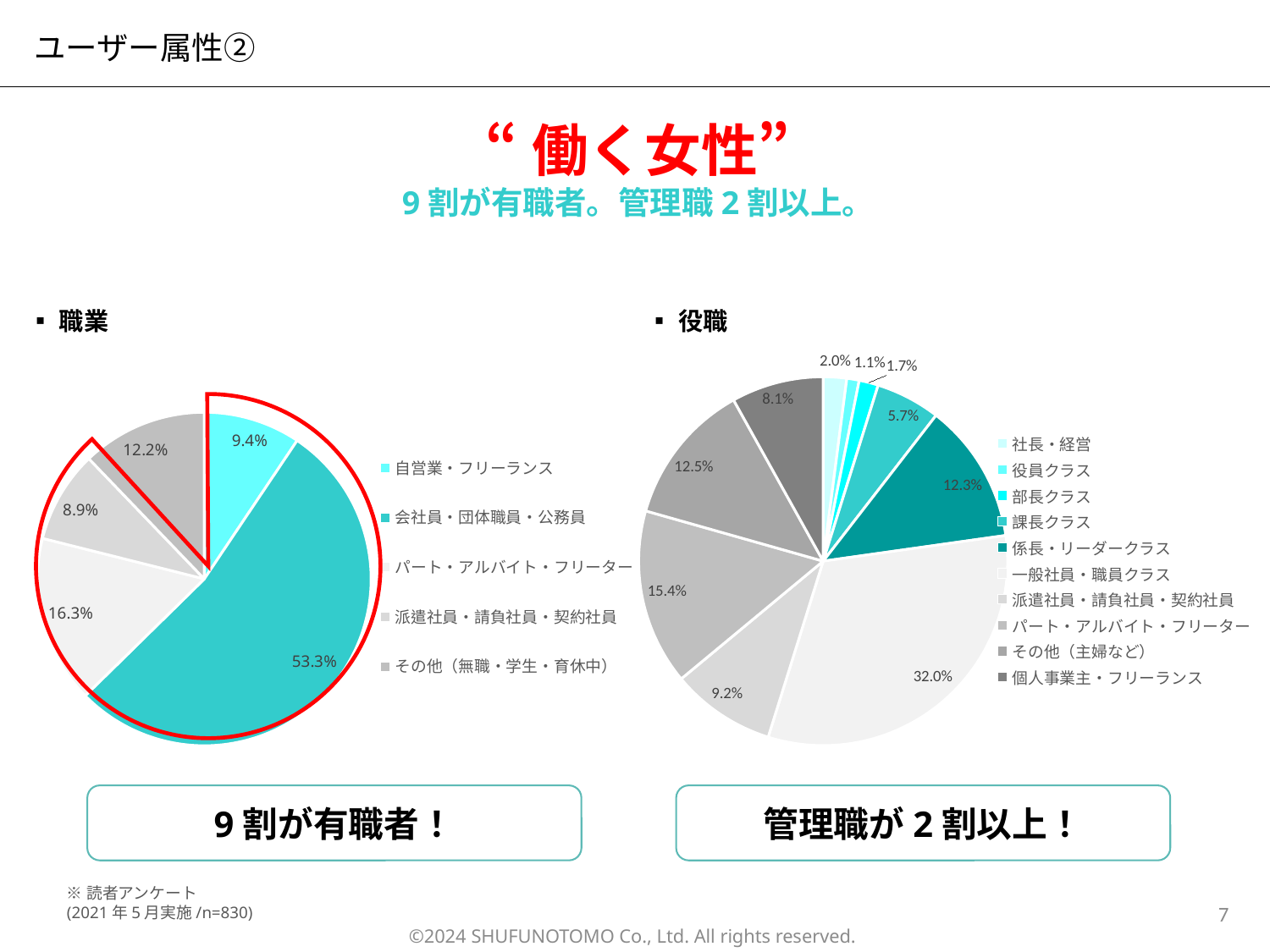
What type of chart is used for 役職? Pie chart In the 職業 pie chart, which category has the smallest share? 派遣社員・請負社員・契約社員 In the 役職 pie chart, what percentage is shown for 係長・リーダークラス? 12.3% In the 役職 pie chart, what percentage is shown for 一般社員・職員クラス? 32.0% In the 職業 pie chart, what percentage is shown for パート・アルバイト・フリーター? 16.3% In the 職業 pie chart, what is the difference between the shares of 会社員・団体職員・公務員 and 自営業・フリーランス? 43.9% In the 役職 pie chart, which category has the smallest share? 役員クラス In the 職業 pie chart, which category has the largest share? 会社員・団体職員・公務員 In the 役職 pie chart, which is larger: パート・アルバイト・フリーター or 派遣社員・請負社員・契約社員? パート・アルバイト・フリーター In the 職業 pie chart, what percentage is shown for 会社員・団体職員・公務員? 53.3% How many categories does the 職業 pie chart show? 5 How many categories does the 役職 pie chart legend list? 10